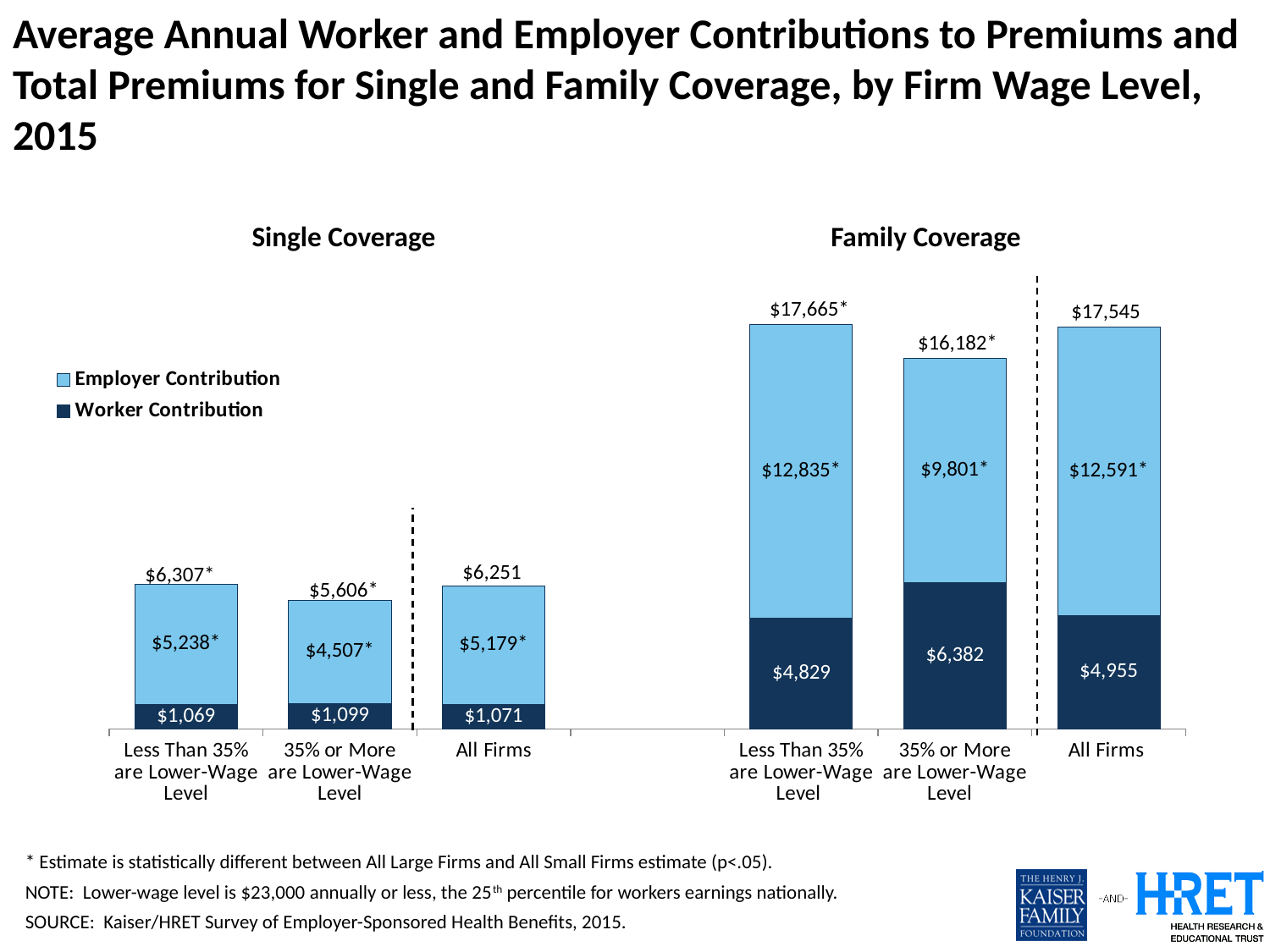
How many firm wage level categories are shown in the Family Coverage panel? 3 In the Family Coverage panel, what is the difference between the Worker Contribution for 35% or More are Lower-Wage Level and for Less Than 35% are Lower-Wage Level? $1,553 How many series does the legend list? 2 In the Family Coverage panel, what is the total premium for All Firms? $17,545 What type of chart is shown on the slide? Stacked bar chart In the Single Coverage panel, which firm wage level category has the lowest total premium? 35% or More are Lower-Wage Level In the Single Coverage panel, is the Employer Contribution larger for Less Than 35% are Lower-Wage Level or for All Firms? Less Than 35% are Lower-Wage Level In the Single Coverage panel, what is the total premium for firms where 35% or More are Lower-Wage Level? $5,606* Which colour represents the Worker Contribution in the chart? Dark blue In the Family Coverage panel, which firm wage level category has the highest Worker Contribution? 35% or More are Lower-Wage Level In the Single Coverage panel, what is the Worker Contribution for firms where Less Than 35% are Lower-Wage Level? $1,069 In the Family Coverage panel, what is the Employer Contribution for firms where 35% or More are Lower-Wage Level? $9,801*